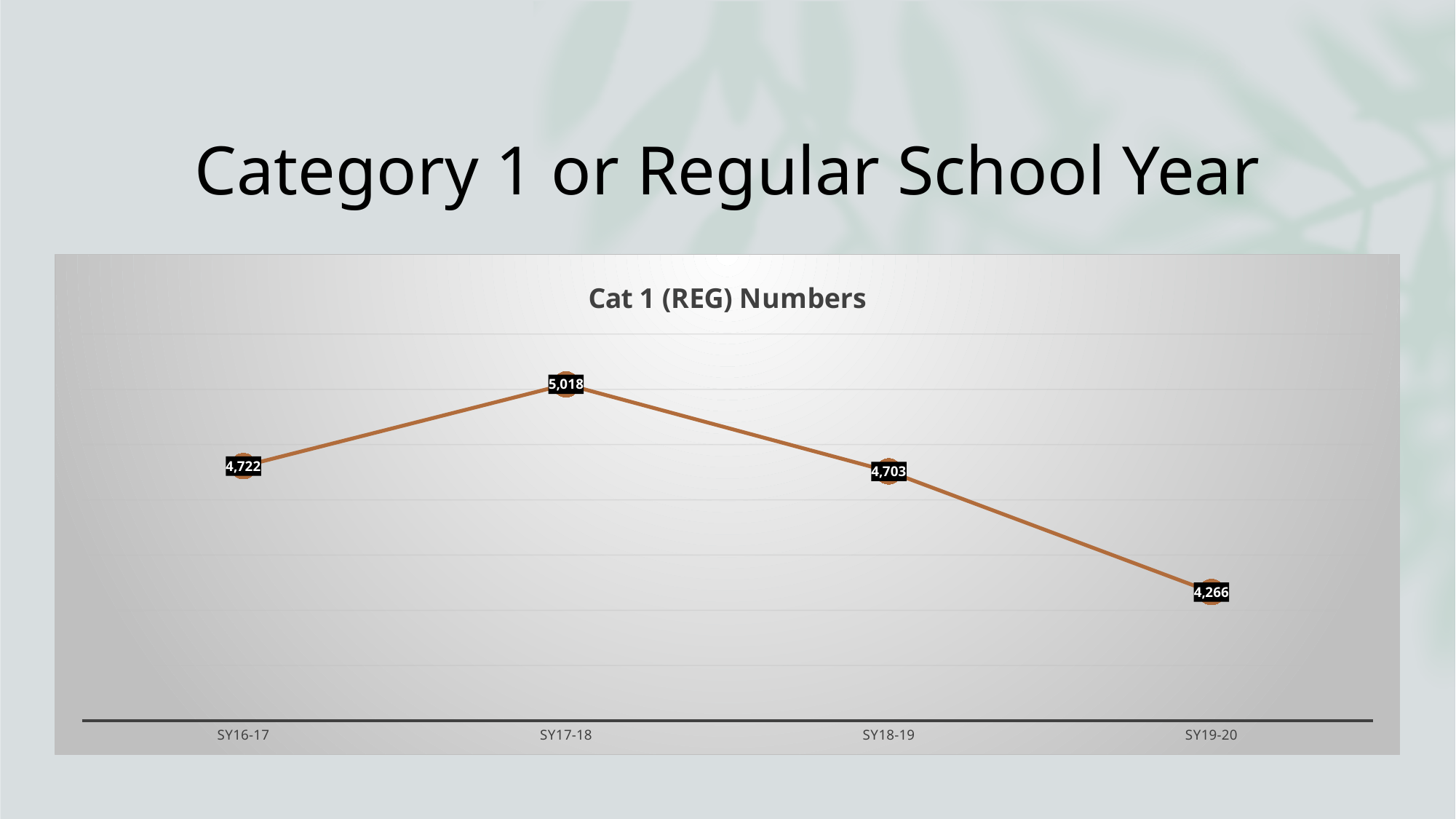
What is the difference between the values for SY16-17 and SY18-19? 19 What is the difference between the values for SY17-18 and SY19-20? 752 What kind of chart is shown? line chart How many school years are plotted on the chart? 4 What is the title of the chart? Cat 1 (REG) Numbers What is the value for SY19-20? 4,266 What is the value for SY17-18? 5,018 What is the value for SY18-19? 4,703 Which is larger, the value for SY16-17 or the value for SY19-20? SY16-17 Which school year has the highest value? SY17-18 What is the value for SY16-17? 4,722 Which school year has the lowest value? SY19-20